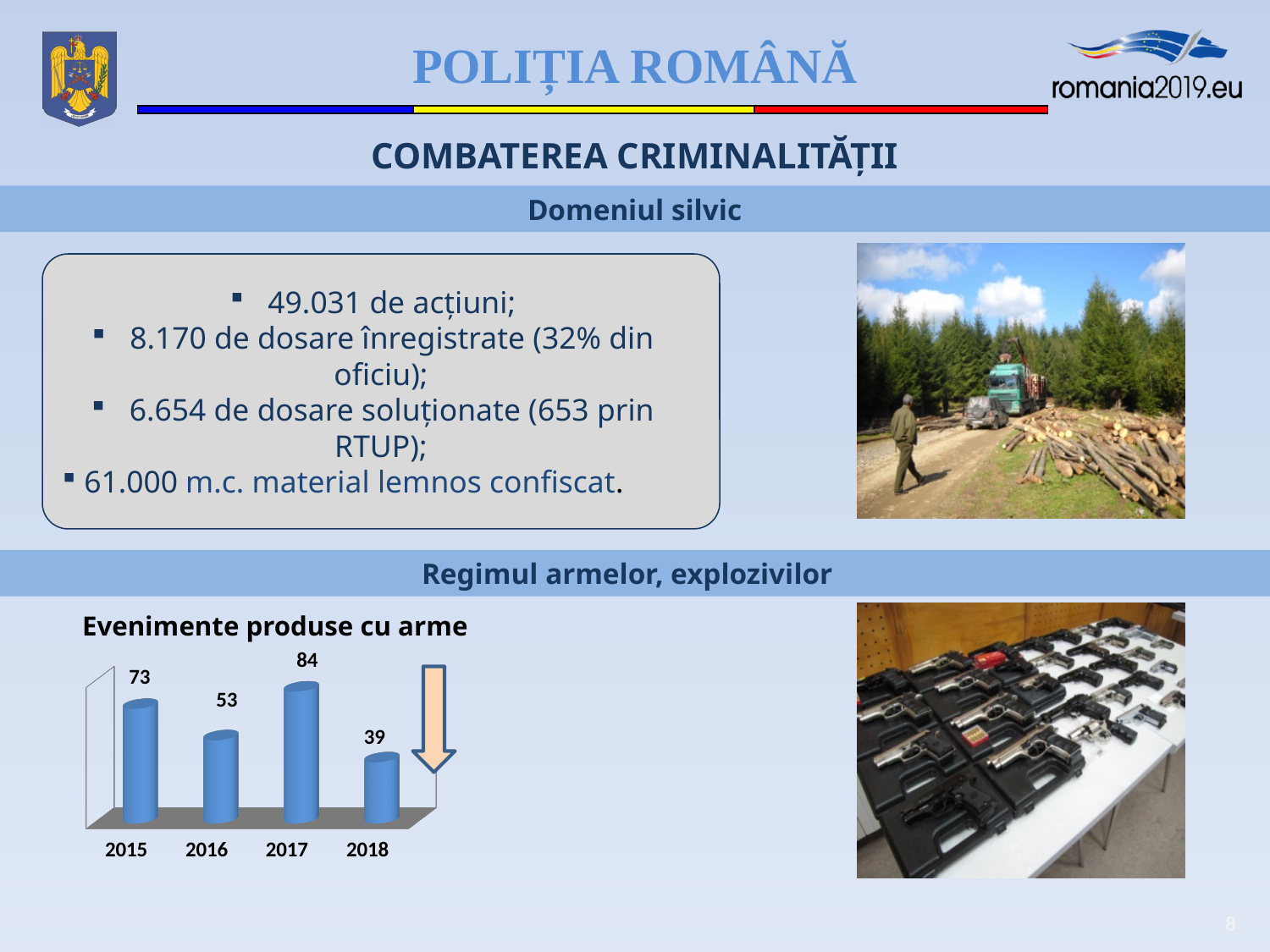
Which year has the highest value in the 'Evenimente produse cu arme' chart? 2017 Which year has the lowest value in the 'Evenimente produse cu arme' chart? 2018 What kind of chart is 'Evenimente produse cu arme'? bar chart In the 'Evenimente produse cu arme' chart, which is larger, the value for 2015 or the value for 2016? 2015 What is the value for 2017 in the 'Evenimente produse cu arme' chart? 84 What is the title of the chart on the slide? Evenimente produse cu arme What is the value for 2018 in the 'Evenimente produse cu arme' chart? 39 What is the difference between the 2017 and 2018 values in the 'Evenimente produse cu arme' chart? 45 What is the value for 2016 in the 'Evenimente produse cu arme' chart? 53 What is the difference between the 2015 and 2016 values in the 'Evenimente produse cu arme' chart? 20 What is the value for 2015 in the 'Evenimente produse cu arme' chart? 73 How many years are shown in the 'Evenimente produse cu arme' chart? 4